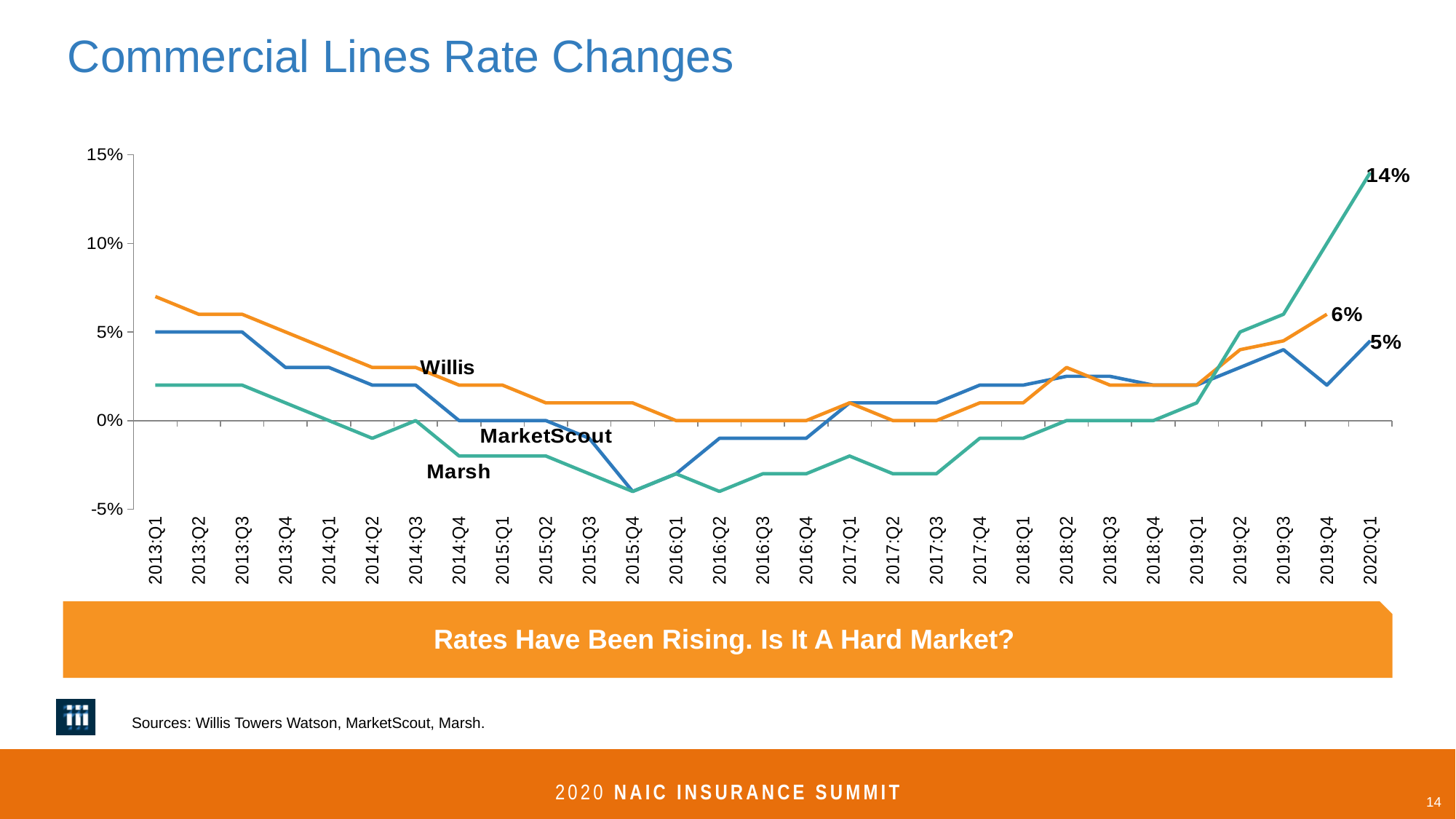
Is the value for Willis at 2013:Q1 greater or less than 5%? greater What is the last labelled value for Willis? 6% Which series has the highest value at 2020:Q1? Marsh How many series are plotted on the chart? 3 Is the value for Marsh at 2020:Q1 greater or less than 10%? greater What is the difference between the Marsh and MarketScout values at 2020:Q1? 9 percentage points At 2020:Q1, which is larger: the Marsh value or the MarketScout value? Marsh What kind of chart is shown on the slide? line chart Is the value for MarketScout at 2015:Q4 greater or less than 0%? less What is the value for MarketScout at 2020:Q1? 5% What is the value for Marsh at 2020:Q1? 14% How many quarters are shown on the x axis? 29